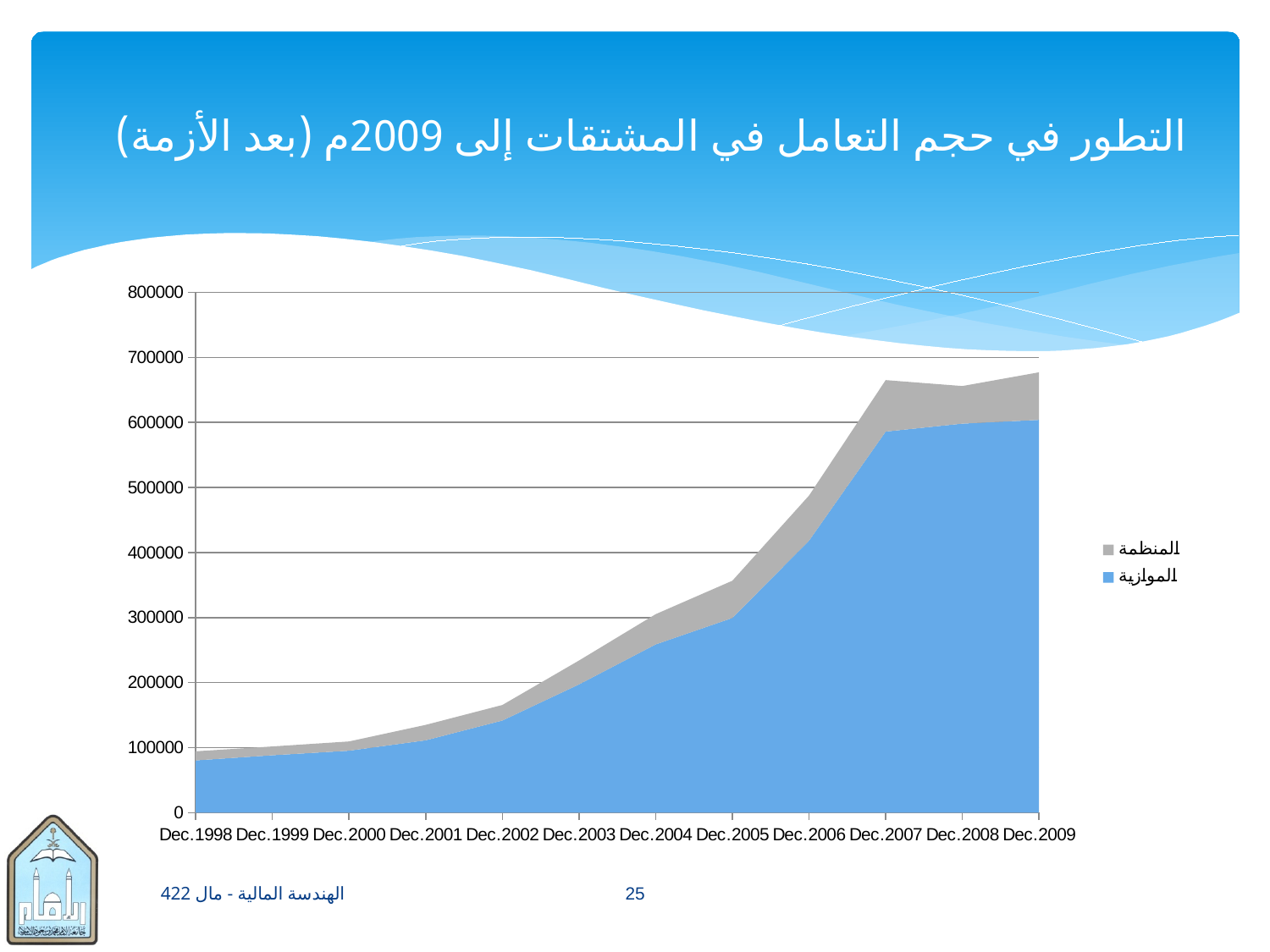
Is the value for الموازية at Dec.1998 greater or less than 100000? less Which series is shown in blue according to the legend? الموازية Which series is shown in gray according to the legend? المنظمة How many series does the legend list? 2 Is the combined total of both series at Dec.2002 greater or less than 200000? less Is the combined total of both series at Dec.2009 greater or less than 700000? less What kind of chart is shown on the slide? area chart Do the stacked values generally rise or fall from Dec.1998 to Dec.2009? rise Which time point has the lowest combined total of both series? Dec.1998 How many time points are shown on the x axis? 12